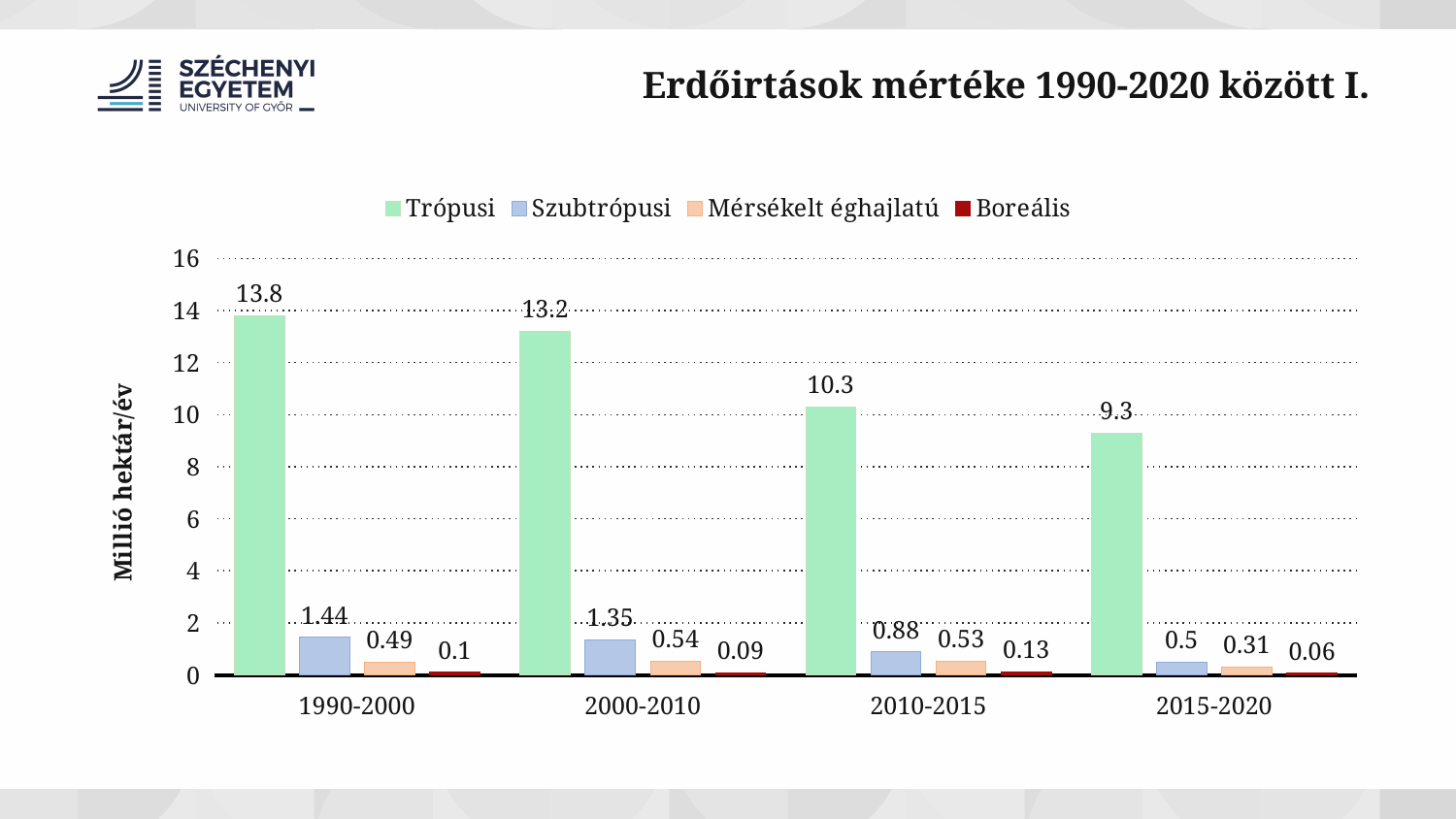
What is the value for Boreális in 2015-2020? 0.06 Do the Trópusi values rise or fall across the periods from 1990-2000 to 2015-2020? fall What is the value for Mérsékelt éghajlatú in 2010-2015? 0.53 In which period is the Trópusi value highest? 1990-2000 What is the value for Trópusi in 1990-2000? 13.8 How many series does the legend list? 4 What is the value for Szubtrópusi in 2000-2010? 1.35 What is the difference between the Trópusi values for 1990-2000 and 2015-2020? 4.5 In which period is the Boreális value lowest? 2015-2020 What kind of chart is shown? bar chart How many periods are shown on the x axis? 4 Which is larger, the Szubtrópusi value in 1990-2000 or in 2015-2020? 1990-2000